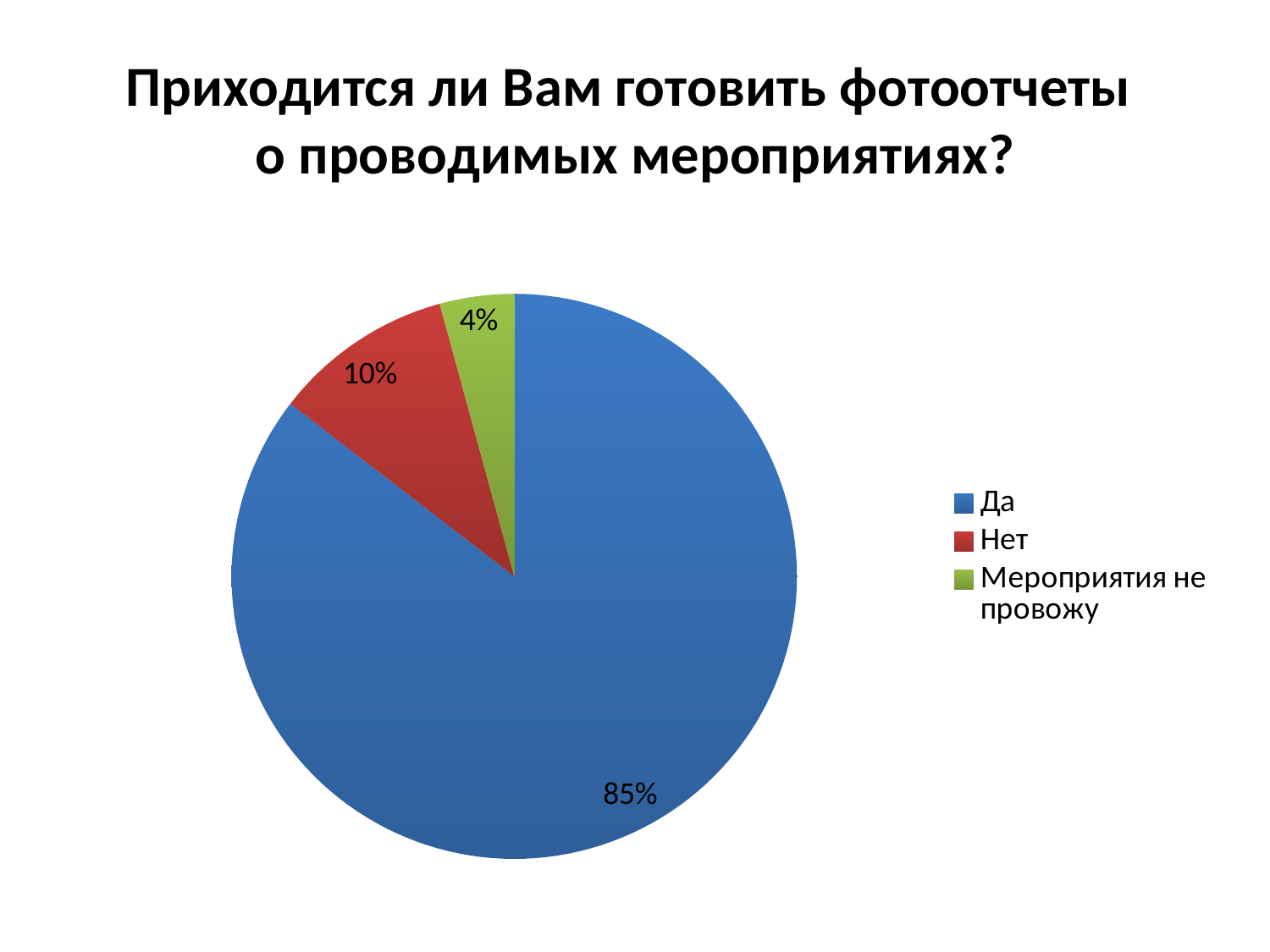
What kind of chart is shown on the slide? pie chart Which is larger, the share for "Нет" or the share for "Мероприятия не провожу"? Нет What is the title of the chart? Приходится ли Вам готовить фотоотчеты о проводимых мероприятиях? What colour is the slice for "Нет"? red What is the difference between the shares for "Да" and "Нет"? 75% Which category has the largest slice of the pie? Да What is the value shown for "Нет"? 10% How many slices does the pie chart have? 3 Which category has the smallest slice of the pie? Мероприятия не провожу What is the difference between the shares for "Нет" and "Мероприятия не провожу"? 6% What is the value shown for "Мероприятия не провожу"? 4% What share of the pie does "Да" take? 85%